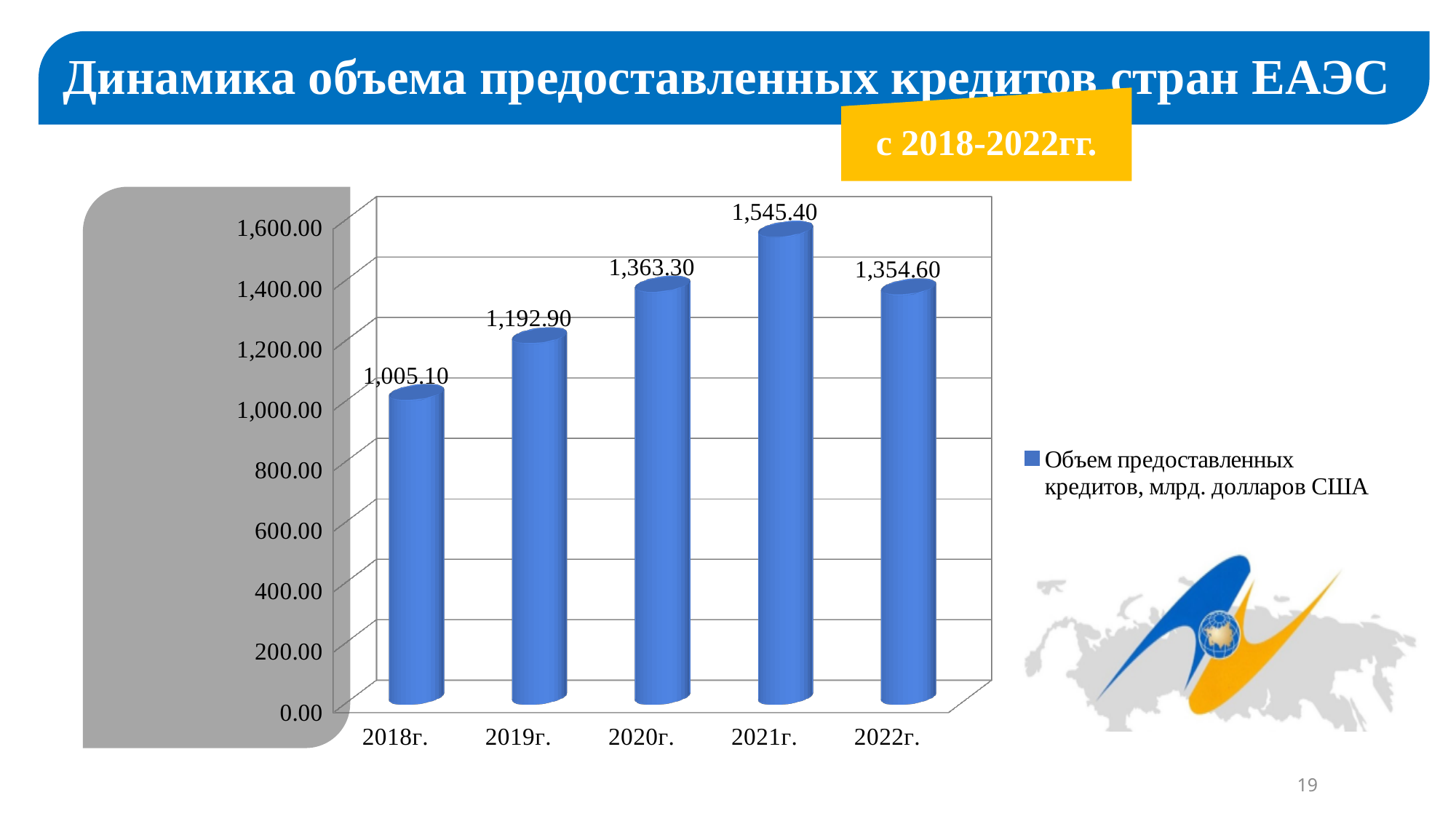
Which is larger, the value for 2020г. or the value for 2019г.? 2020г. What is the legend entry for the series? Объем предоставленных кредитов, млрд. долларов США What is the value for 2022г.? 1,354.60 What kind of chart is shown on the slide? bar chart What is the difference between the values for 2019г. and 2018г.? 187.80 How many years are shown on the x axis? 5 Which year has the lowest value? 2018г. What is the value for 2018г.? 1,005.10 What is the difference between the values for 2021г. and 2022г.? 190.80 What is the value for 2021г.? 1,545.40 Is the value for 2019г. greater or less than 1,000.00? greater Which year has the highest value? 2021г.